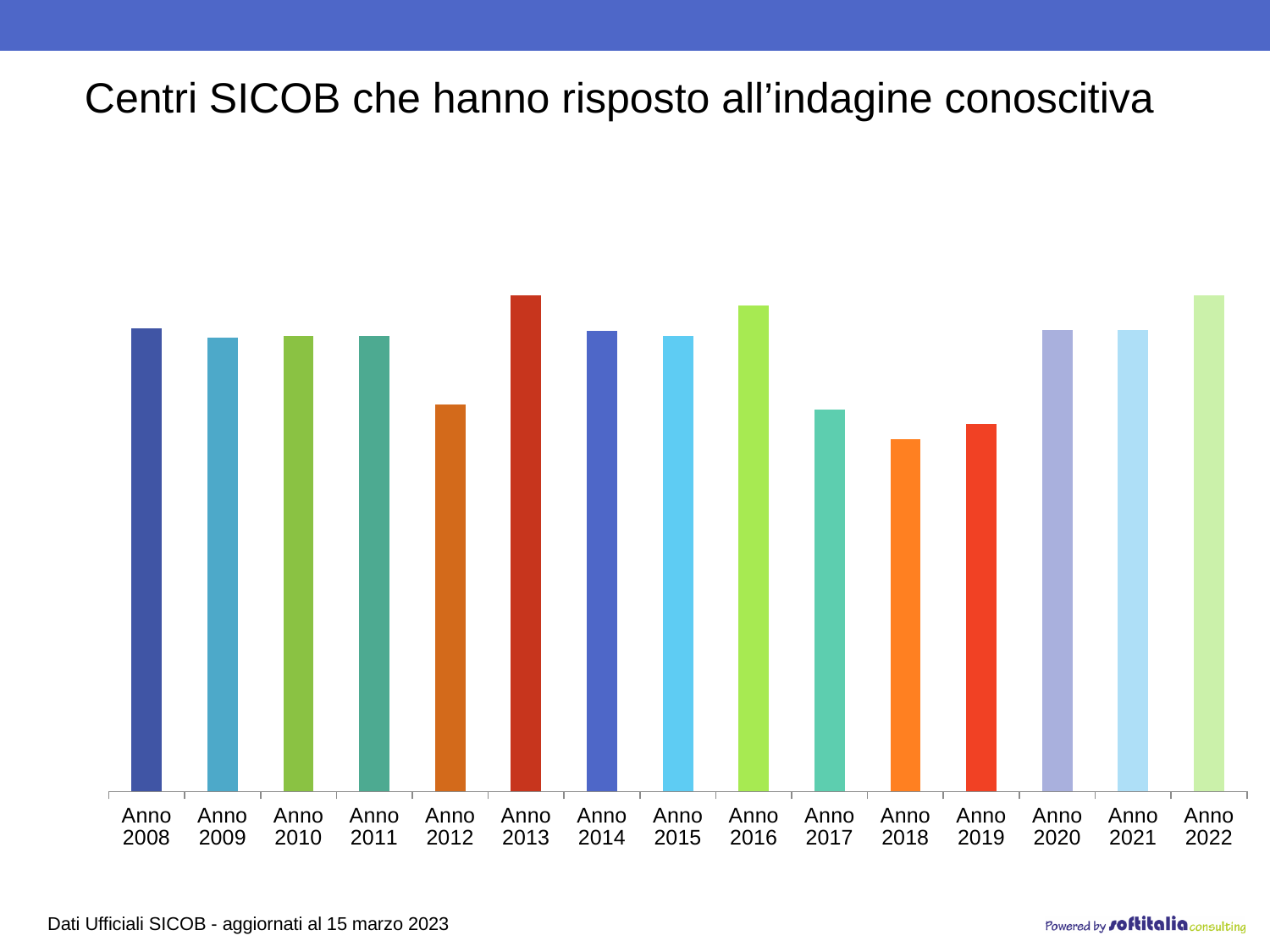
How many years (categories) are shown on the x axis of the chart? 15 Which year has the lowest bar in the chart? Anno 2018 Which bar is taller, Anno 2012 or Anno 2013? Anno 2013 Do the bars rise or fall from Anno 2018 to Anno 2022? rise What is the first year shown on the x axis of the chart? Anno 2008 What is the title of the slide containing the chart? Centri SICOB che hanno risposto all'indagine conoscitiva Do the bars rise or fall from Anno 2016 to Anno 2018? fall Which bar is taller, Anno 2018 or Anno 2020? Anno 2020 Which bar is taller, Anno 2008 or Anno 2012? Anno 2008 What kind of chart is shown on the slide? bar chart